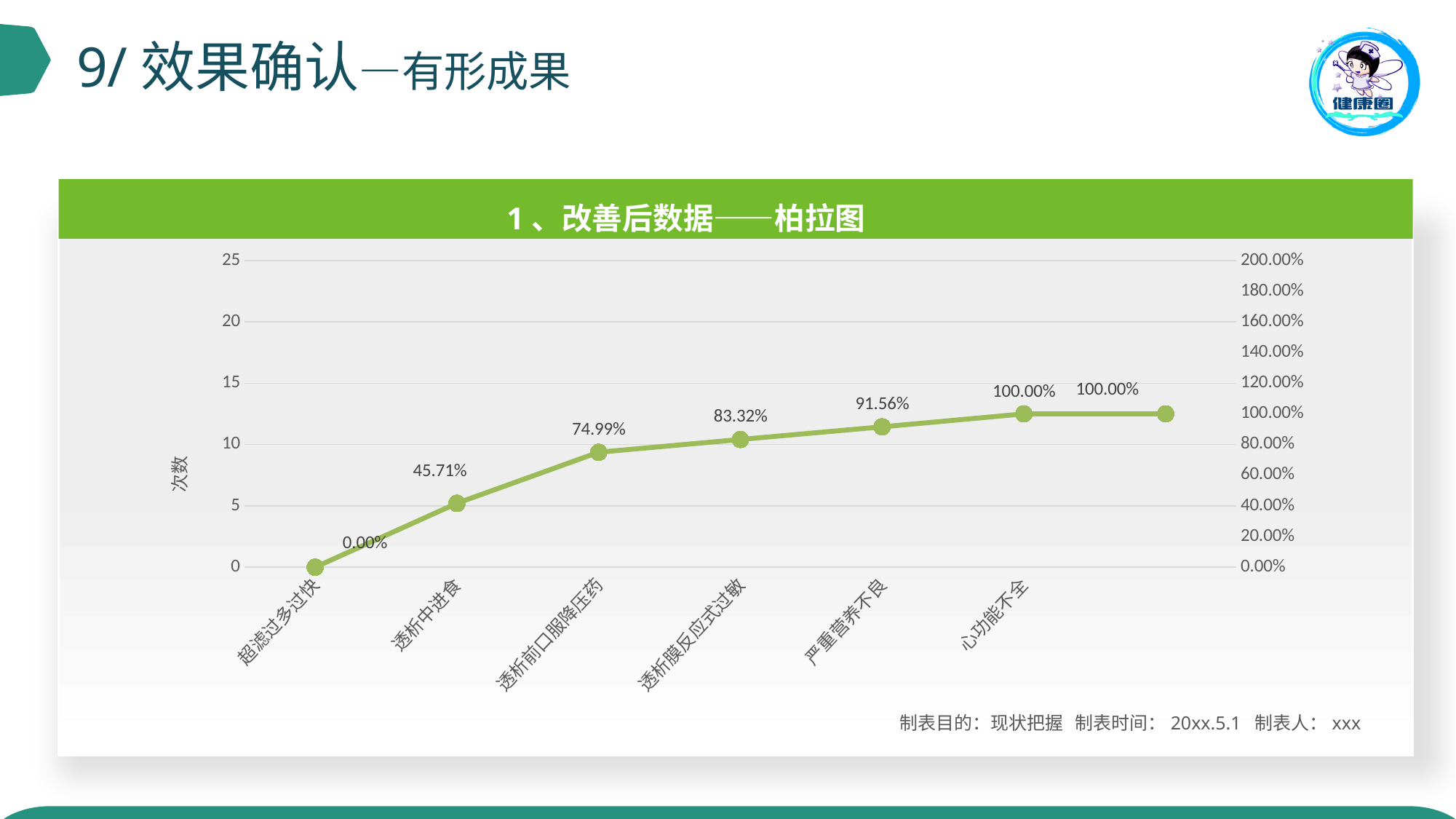
Which labelled category has the lowest value on the line? 超滤过多过快 What type of chart is shown on the slide? line chart What is the value labelled for 透析膜反应式过敏? 83.32% What is the value labelled for 严重营养不良? 91.56% What is the cumulative percentage value labelled for 透析中进食? 45.71% How many category labels are shown on the x axis? 6 What is the value labelled for 透析前口服降压药? 74.99% Which is larger, the value for 严重营养不良 or the value for 透析膜反应式过敏? 严重营养不良 Do the values rise or fall from left to right along the x axis? rise What is the difference between the values for 透析前口服降压药 and 透析中进食? 29.28% What is the title of the chart? 1、改善后数据——柏拉图 What is the value labelled for 心功能不全? 100.00%